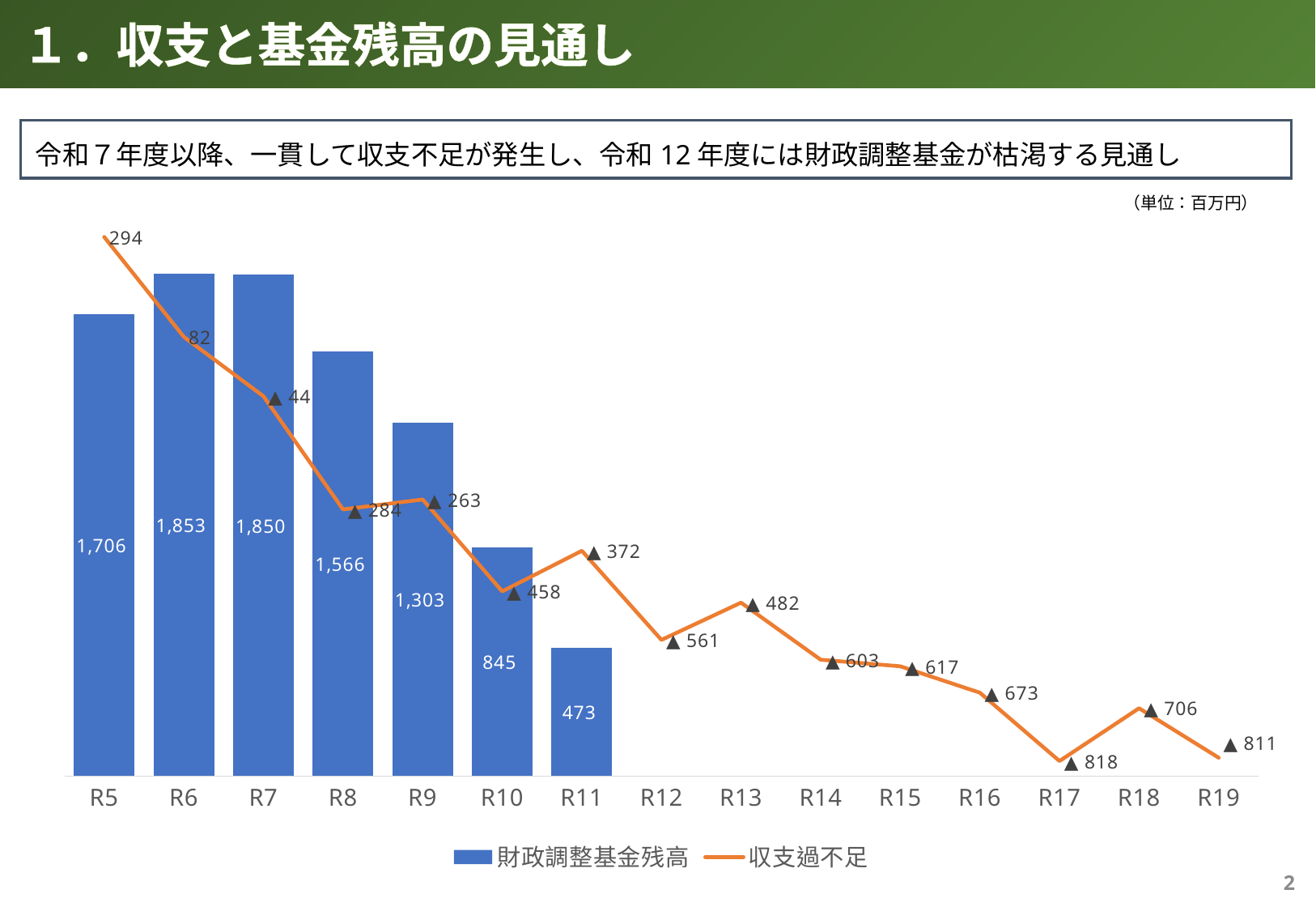
What is the 収支過不足 value shown for R5? 294 What kind of chart is this? Combination bar and line chart Which is larger, the 財政調整基金残高 bar for R9 or for R10? R9 What is the difference between the 財政調整基金残高 bars for R10 and R11? 372 What is the value of the 財政調整基金残高 bar for R8? 1,566 How many years are shown on the x axis? 15 How many 財政調整基金残高 bars are plotted? 7 Do the 財政調整基金残高 bars rise or fall from R7 to R11? Fall Which year has the lowest 財政調整基金残高 bar? R11 How many series does the legend list? 2 What is the difference between the 財政調整基金残高 bars for R5 and R9? 403 What is the 収支過不足 value shown for R12? ▲ 561